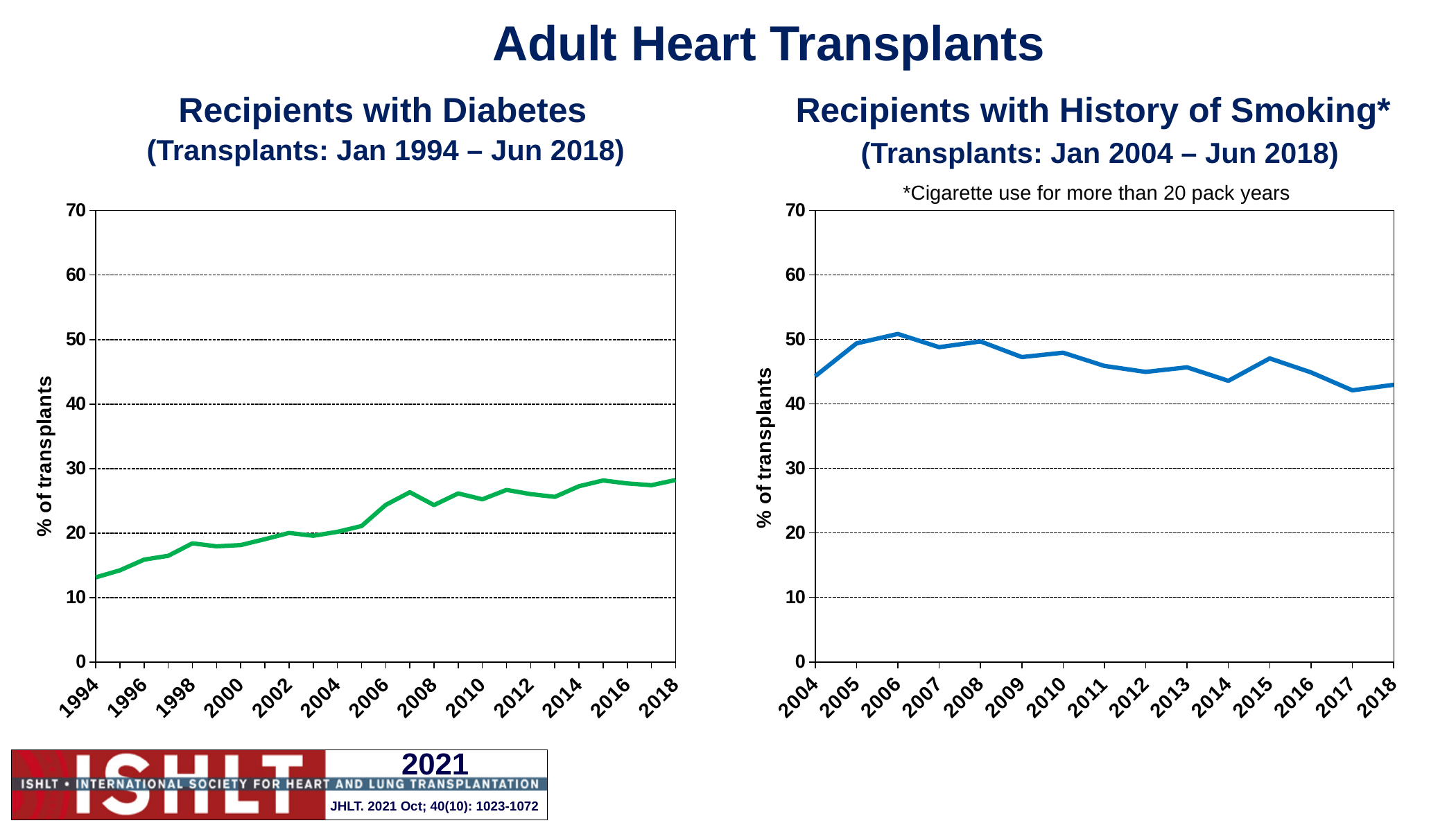
In the 'Recipients with History of Smoking*' chart, is the value for 2012 greater or less than 50? less In the 'Recipients with History of Smoking*' chart, which year has the highest value? 2006 In the 'Recipients with Diabetes' chart, which year has the lowest value? 1994 In the 'Recipients with Diabetes' chart, is the value for 2018 greater or less than 30? less In the 'Recipients with Diabetes' chart, is the value for 2007 greater or less than 20? greater In the 'Recipients with History of Smoking*' chart, which year has the lowest value? 2017 In the 'Recipients with History of Smoking*' chart, how many years are shown on the x axis? 15 What kind of chart is the 'Recipients with Diabetes' chart? line chart What is the y-axis label of the 'Recipients with History of Smoking*' chart? % of transplants In the 'Recipients with Diabetes' chart, do the values generally rise or fall from 1994 to 2018? rise